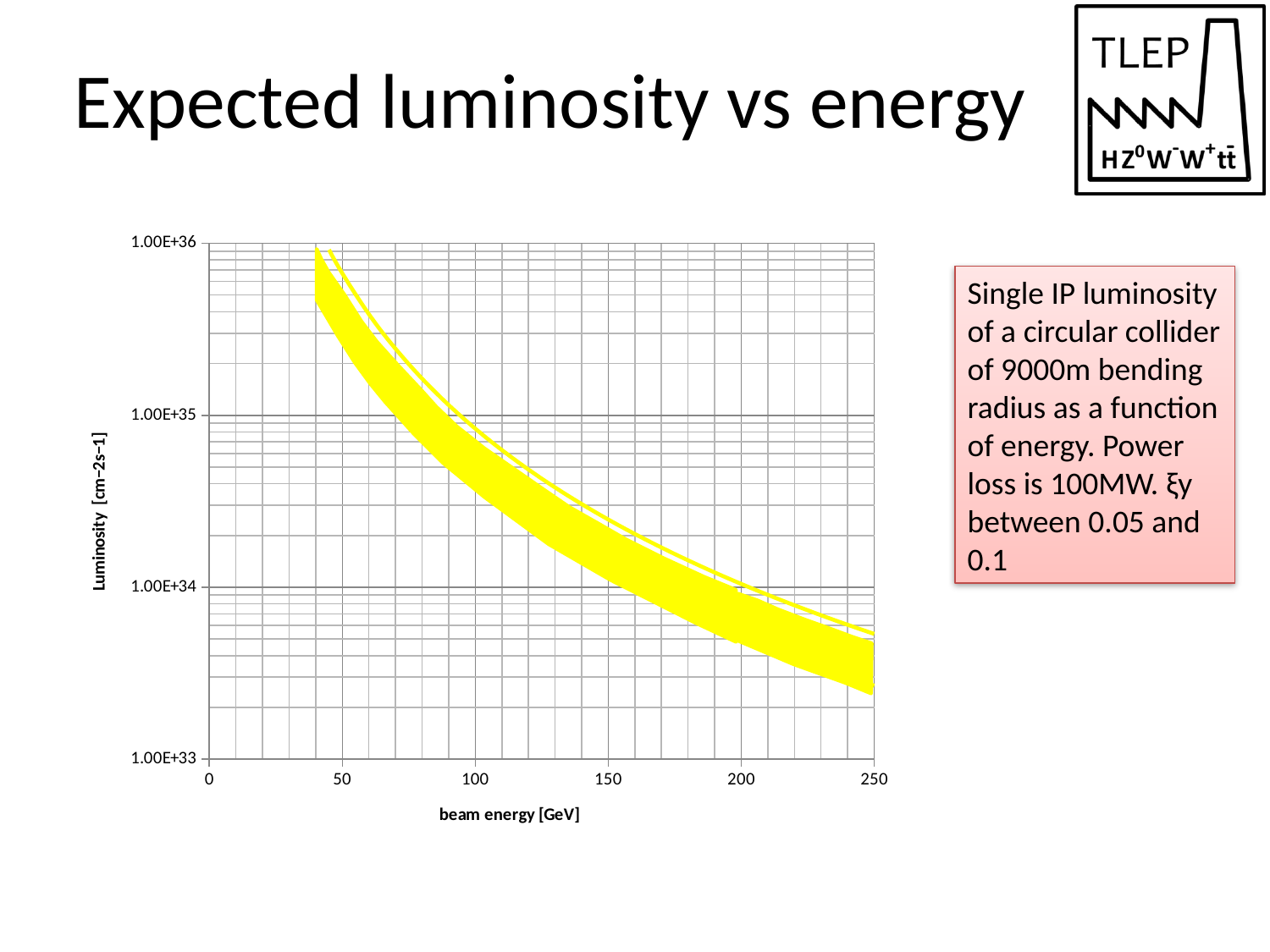
Is the luminosity higher at a beam energy of 50 GeV or at 250 GeV? 50 GeV What is the lowest luminosity value labelled on the y axis? 1.00E+33 What is the label of the y axis of the chart? Luminosity [cm–2s–1] What is the highest beam energy tick shown on the x axis? 250 Is the luminosity higher at a beam energy of 200 GeV or at 100 GeV? 100 GeV At a beam energy of 250 GeV, is the luminosity band greater or less than 1.00E+34? less How does the expected luminosity change as beam energy increases along the x axis? It decreases What is the label of the x axis of the chart? beam energy [GeV] At a beam energy of 150 GeV, is the luminosity band greater or less than 1.00E+34? greater At a beam energy of 50 GeV, is the luminosity band greater or less than 1.00E+35? greater What kind of chart is used to show luminosity versus beam energy? Area chart (shaded band)